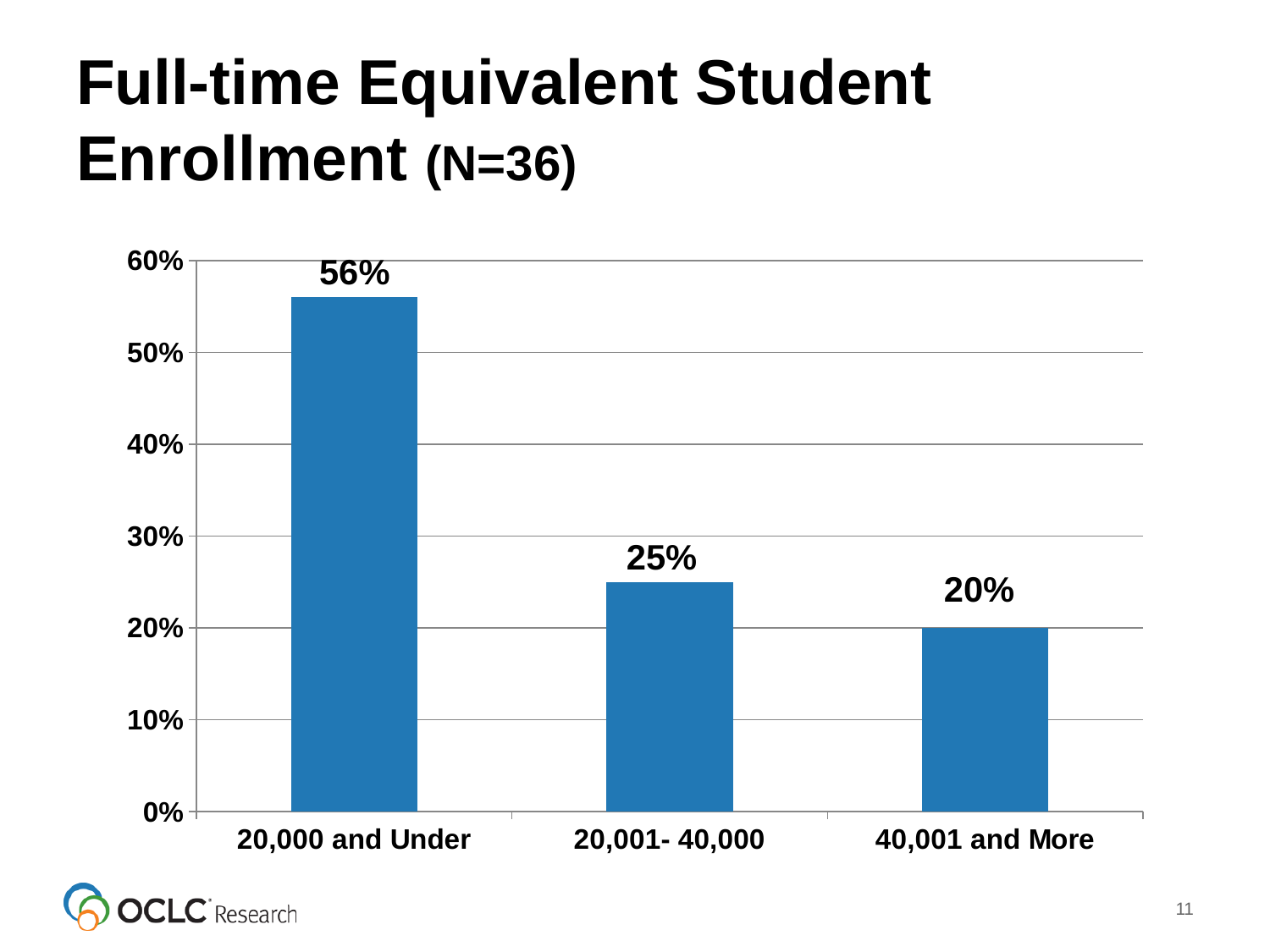
Which is larger, the value for '20,001- 40,000' or the value for '40,001 and More'? 20,001- 40,000 How many enrollment categories are shown on the chart? 3 What percentage is shown for the '20,000 and Under' category? 56% What kind of chart is shown on the slide? Bar chart Do the values rise or fall moving from left to right across the categories? Fall Is the value for '20,000 and Under' greater or less than 50%? greater Which enrollment category has the highest percentage? 20,000 and Under What is the difference in percentage points between '20,001- 40,000' and '40,001 and More'? 5 percentage points Which enrollment category has the lowest percentage? 40,001 and More What percentage is shown for the '20,001- 40,000' category? 25% What percentage is shown for the '40,001 and More' category? 20% What is the difference in percentage points between '20,000 and Under' and '20,001- 40,000'? 31 percentage points